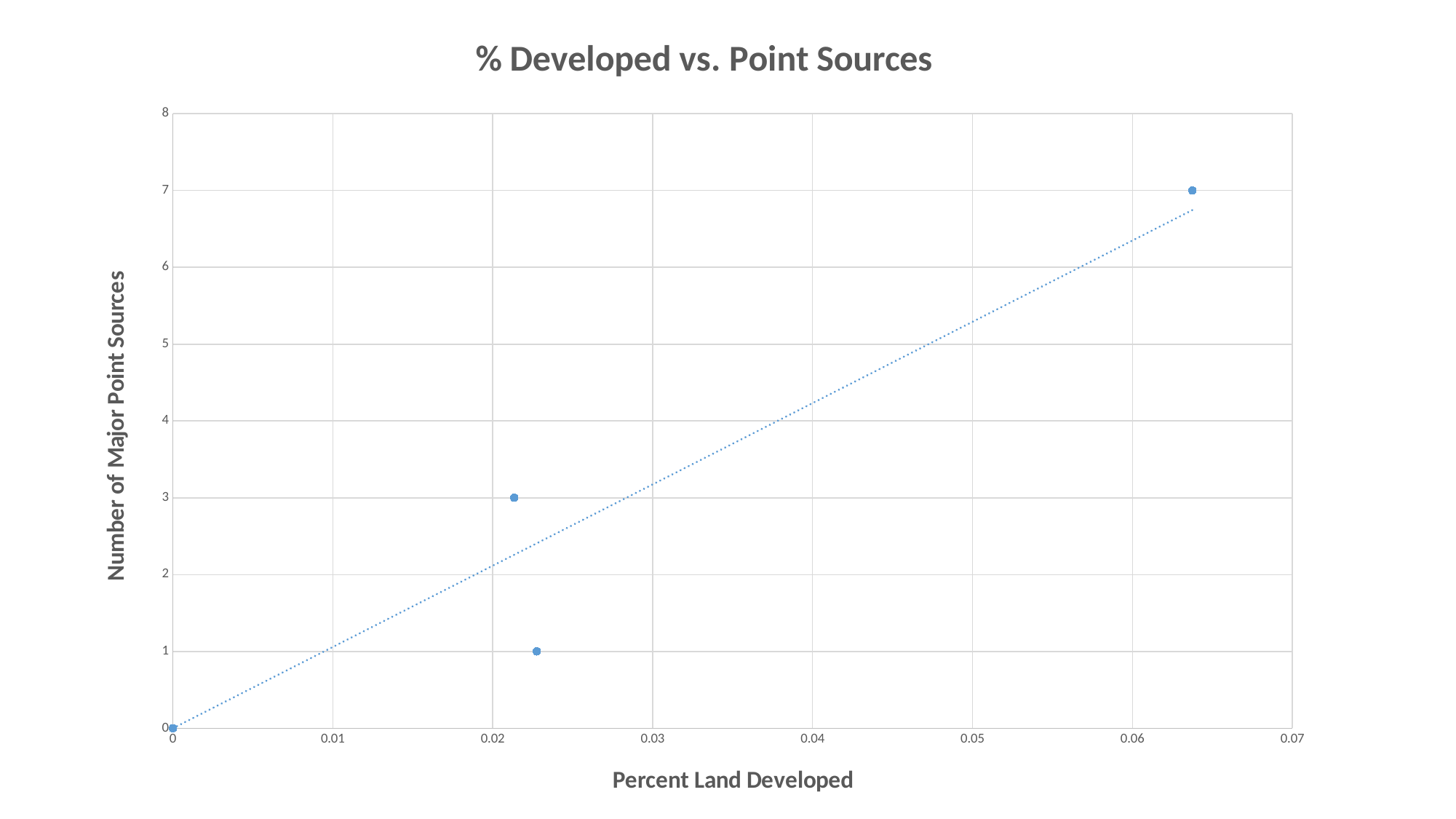
What is the difference in number of major point sources between the highest point and the point at 3 major point sources? 4 How many data points are plotted on the chart? 4 Which has more major point sources: the point near 0.064 Percent Land Developed or the point near 0.021 Percent Land Developed? the point near 0.064 Is the Percent Land Developed value for the point with 1 major point source greater or less than 0.03? less What is the lowest number of major point sources plotted on the chart? 0 Is the Percent Land Developed value for the point with 7 major point sources greater or less than 0.06? greater Does the dotted trend line rise or fall as Percent Land Developed increases? rises Is the Percent Land Developed value for the point with 3 major point sources greater or less than 0.02? greater What is the highest number of major point sources plotted on the chart? 7 What kind of chart is shown on the slide? scatter chart What is the label of the vertical axis? Number of Major Point Sources What is the title of the chart? % Developed vs. Point Sources